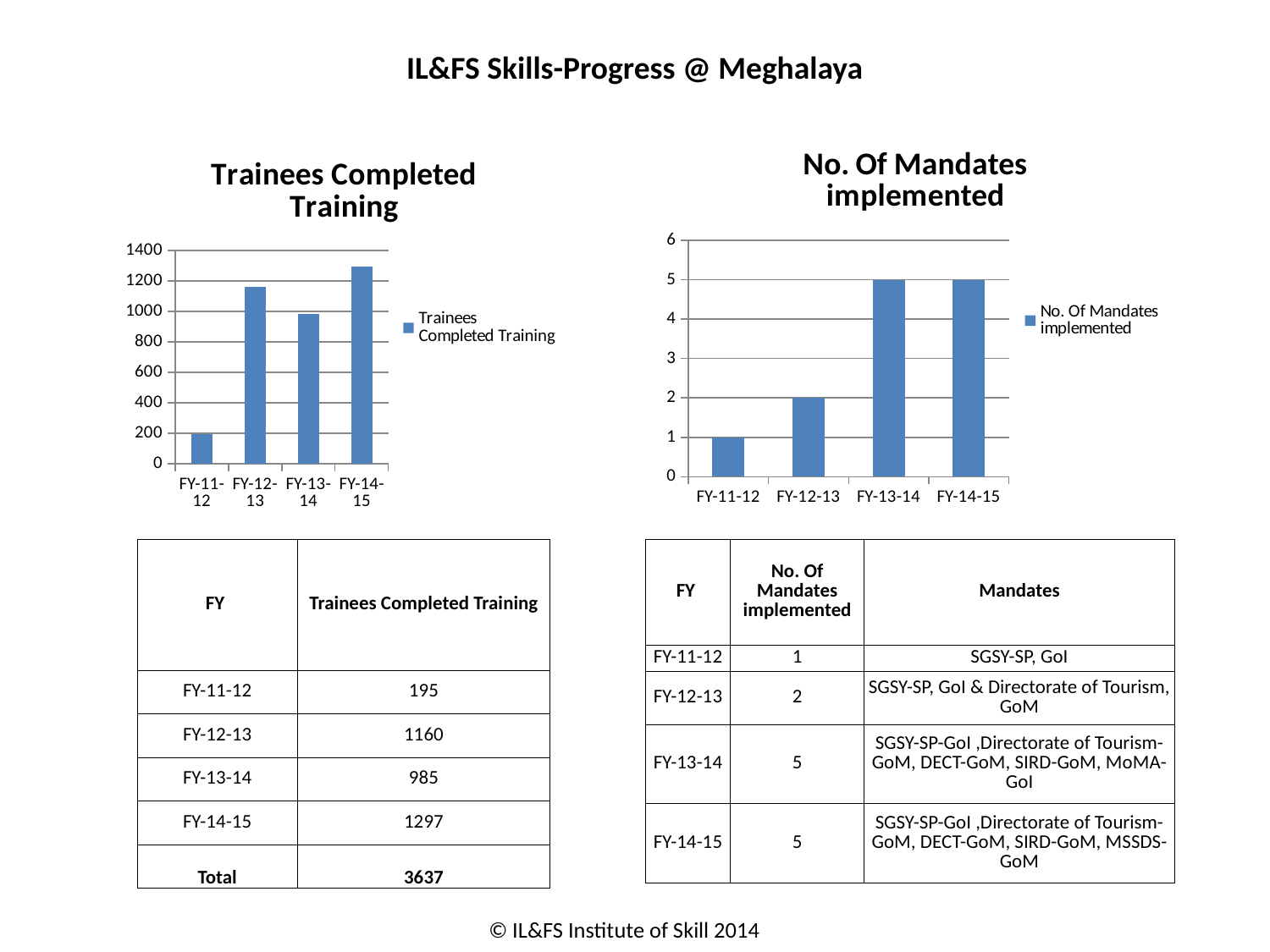
In the 'Trainees Completed Training' chart, which fiscal year has the lowest value? FY-11-12 In the 'Trainees Completed Training' chart, is the value for FY-12-13 greater or less than 1000? greater In the 'Trainees Completed Training' chart, is the value for FY-13-14 greater or less than 1000? less In the 'No. Of Mandates implemented' chart, what is the difference between the values for FY-13-14 and FY-12-13? 3 In the 'No. Of Mandates implemented' chart, what is the value for FY-12-13? 2 In the 'Trainees Completed Training' chart, how many fiscal years are plotted? 4 In the 'No. Of Mandates implemented' chart, what is the value for FY-11-12? 1 In the 'Trainees Completed Training' chart, what kind of chart is shown? bar chart In the 'Trainees Completed Training' chart, which is larger, the value for FY-12-13 or FY-13-14? FY-12-13 In the 'Trainees Completed Training' chart, which fiscal year has the highest value? FY-14-15 In the 'No. Of Mandates implemented' chart, do the values rise or fall from FY-11-12 to FY-13-14? rise In the 'No. Of Mandates implemented' chart, how many series does the legend list? 1